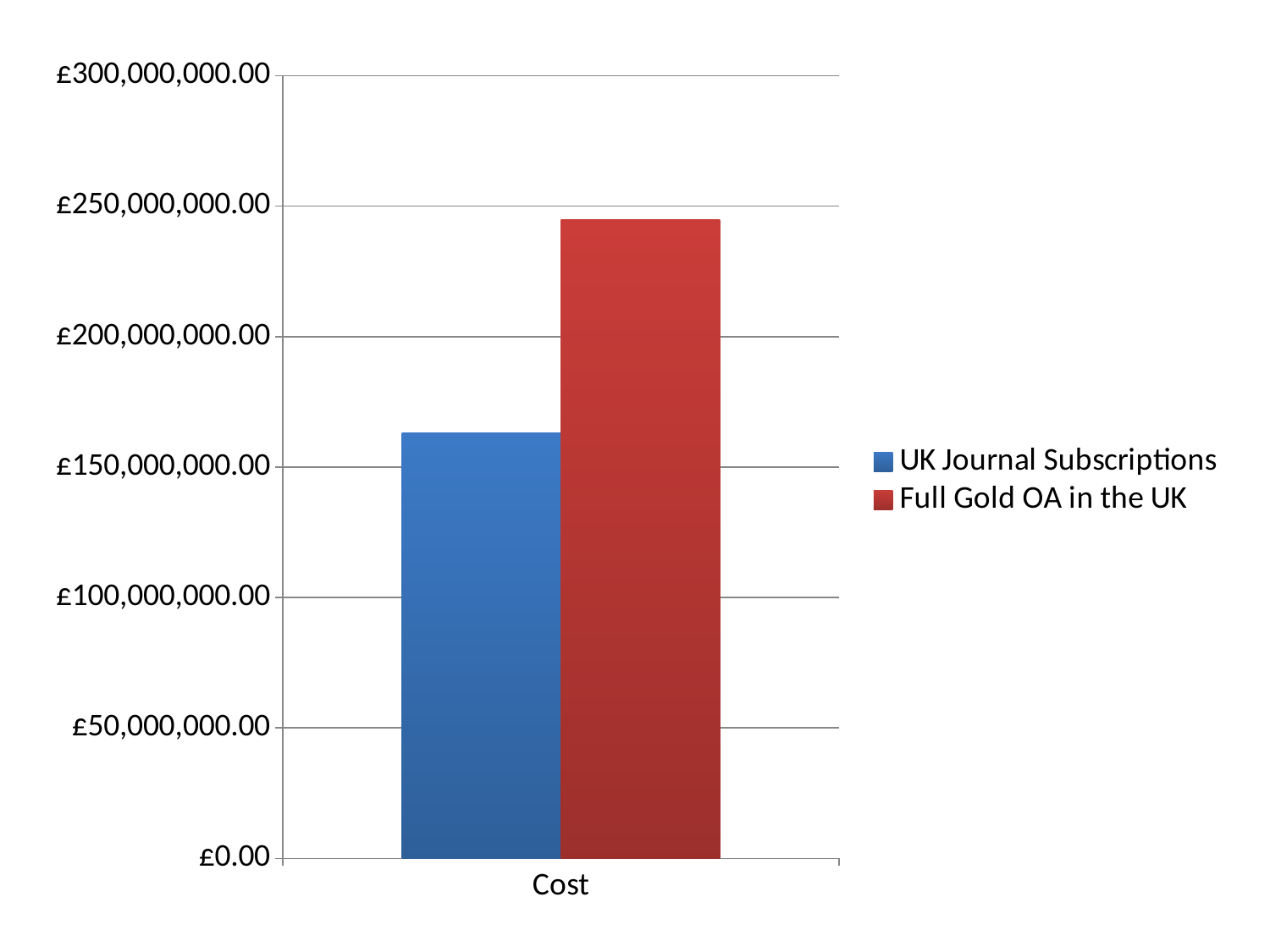
Is the value for UK Journal Subscriptions greater or less than £200,000,000.00? less What is the label of the category on the x axis? Cost What colour is the bar for Full Gold OA in the UK? red How many categories are shown on the x axis? 1 Is the value for Full Gold OA in the UK greater or less than £250,000,000.00? less How many series does the legend list? 2 Which series has the lower value for Cost? UK Journal Subscriptions Is the value for UK Journal Subscriptions greater or less than £150,000,000.00? greater Is the value for Full Gold OA in the UK larger or smaller than the value for UK Journal Subscriptions? larger What kind of chart is shown on the slide? bar chart Which series has the higher value for Cost? Full Gold OA in the UK